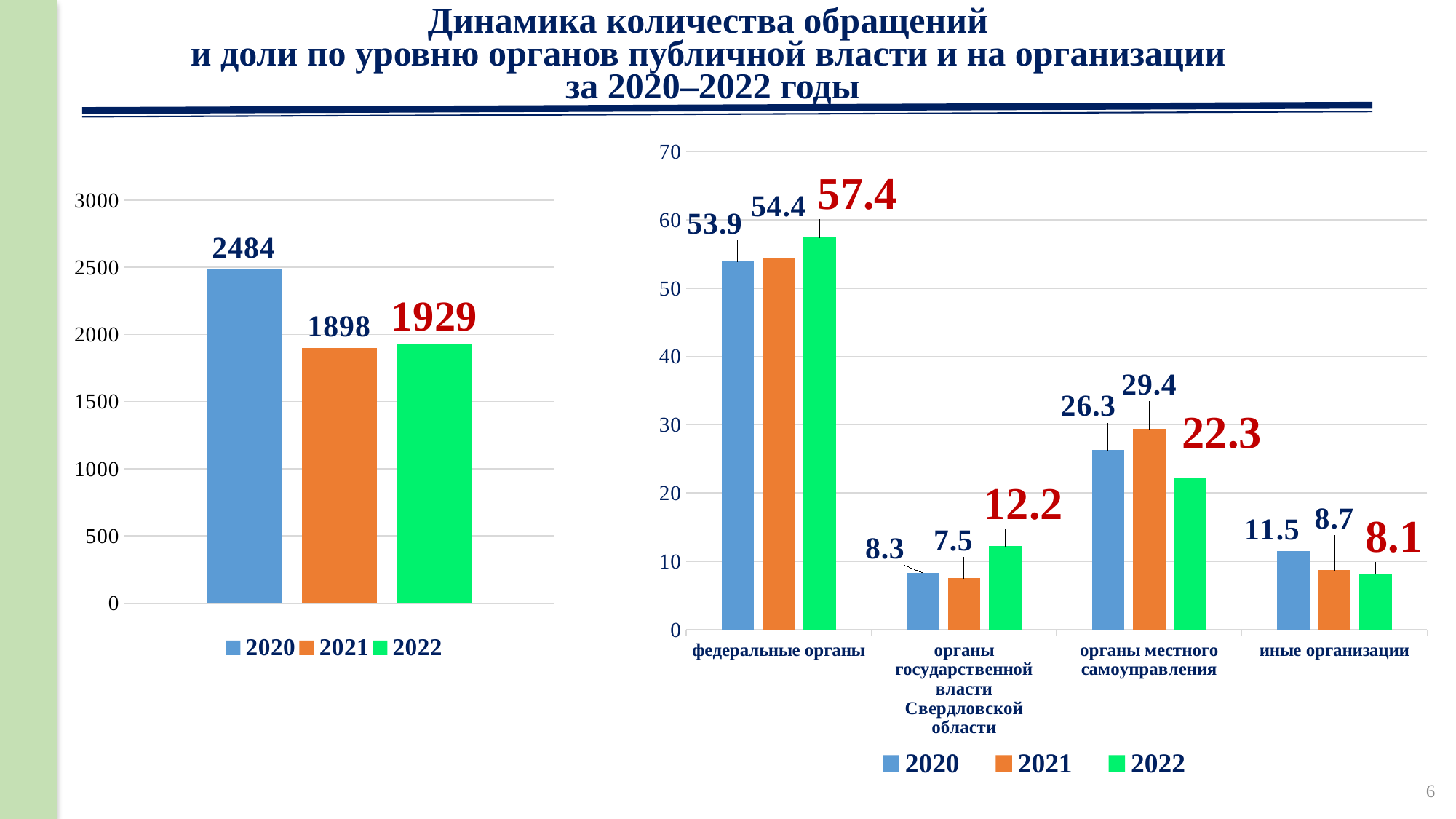
In the left chart, how many series does the legend list? 3 In the right chart, what is the 2022 value for федеральные органы? 57.4 In the right chart, what is the difference between the 2022 and 2021 values for органы государственной власти Свердловской области? 4.7 In the left chart, what is the value for 2020? 2484 In the left chart, which year has the lowest value? 2021 In the left chart, what is the difference between the 2020 and 2021 values? 586 In the right chart, is the 2020 value for иные организации larger or smaller than the 2021 value? larger What kind of chart is the left chart? bar chart In the right chart, what is the 2021 value for органы местного самоуправления? 29.4 In the left chart, what is the value for 2022? 1929 In the right chart, which category has the highest 2022 value? федеральные органы In the right chart, how many categories are shown on the x axis? 4